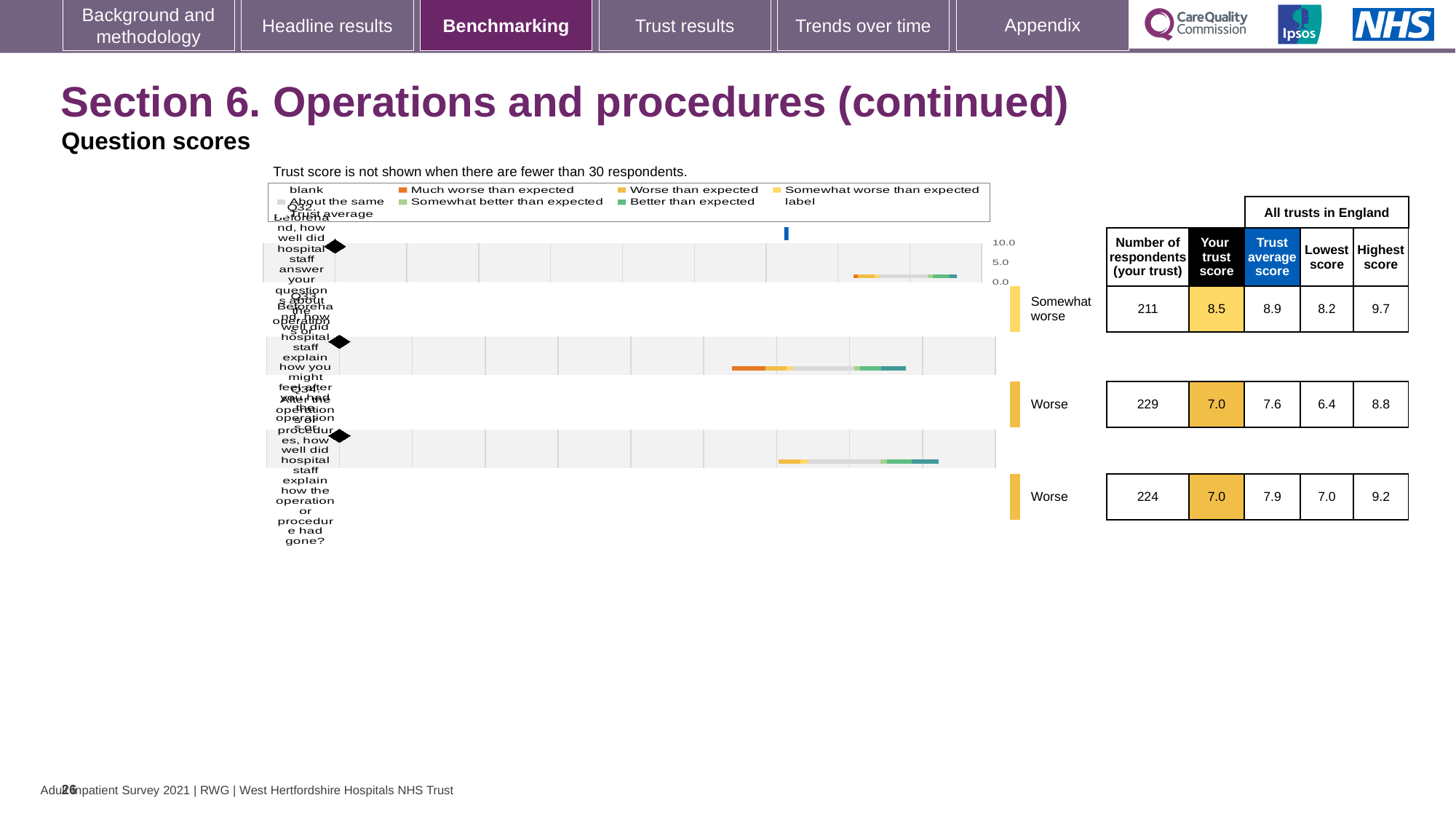
In the table, what is the 'Trust average score' for the second question row? 7.6 In the table, what is 'Your trust score' for the first (top) question row? 8.5 In the table, what is the 'Lowest score' for the second question row? 6.4 Which question row has the highest 'Your trust score' in the table? The first (top) row For the first (top) question row, what is the difference between the 'Highest score' and the 'Lowest score'? 1.5 What kind of chart is used to show the question scores? Bar chart Which has more respondents in the table: the second question row or the third question row? The second row In the table, what is the 'Highest score' for the third (bottom) question row? 9.2 For the third (bottom) question row, what is the difference between the 'Trust average score' and 'Your trust score'? 0.9 How many question rows are shown in the benchmarking chart and table? 3 What benchmark category label is shown next to the first (top) question row? Somewhat worse In the table, what is the number of respondents for the first (top) question row? 211